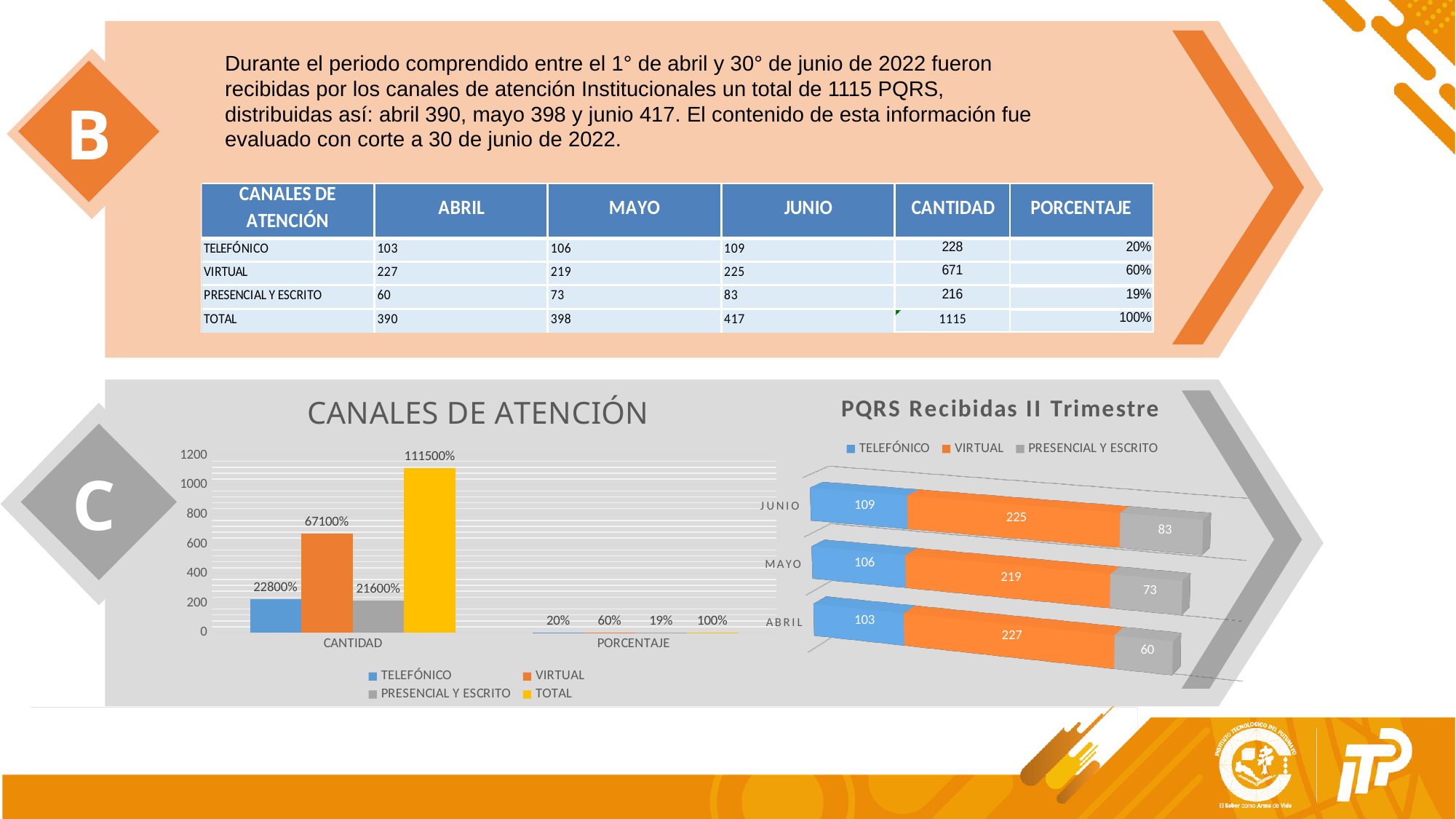
In the 'PQRS Recibidas II Trimestre' chart, what is the total of the stacked bar for JUNIO? 417 In the 'PQRS Recibidas II Trimestre' chart, how many months are shown? 3 In the 'CANALES DE ATENCIÓN' chart, what data label is printed above the TOTAL bar in the CANTIDAD group? 111500% In the 'PQRS Recibidas II Trimestre' chart, how many series does the legend list? 3 In the 'PQRS Recibidas II Trimestre' chart, what is the difference between the VIRTUAL values for ABRIL and MAYO? 8 In the 'CANALES DE ATENCIÓN' chart, which series has the tallest bar in the CANTIDAD group? TOTAL In the 'PQRS Recibidas II Trimestre' chart, what is the total of the stacked bar for ABRIL? 390 In the 'PQRS Recibidas II Trimestre' chart, what is the VIRTUAL value for JUNIO? 225 What kind of chart is 'CANALES DE ATENCIÓN'? Bar chart In the 'PQRS Recibidas II Trimestre' chart, which month has the highest PRESENCIAL Y ESCRITO value? JUNIO In the 'PQRS Recibidas II Trimestre' chart, what is the PRESENCIAL Y ESCRITO value for ABRIL? 60 In the 'PQRS Recibidas II Trimestre' chart, what is the TELEFÓNICO value for MAYO? 106